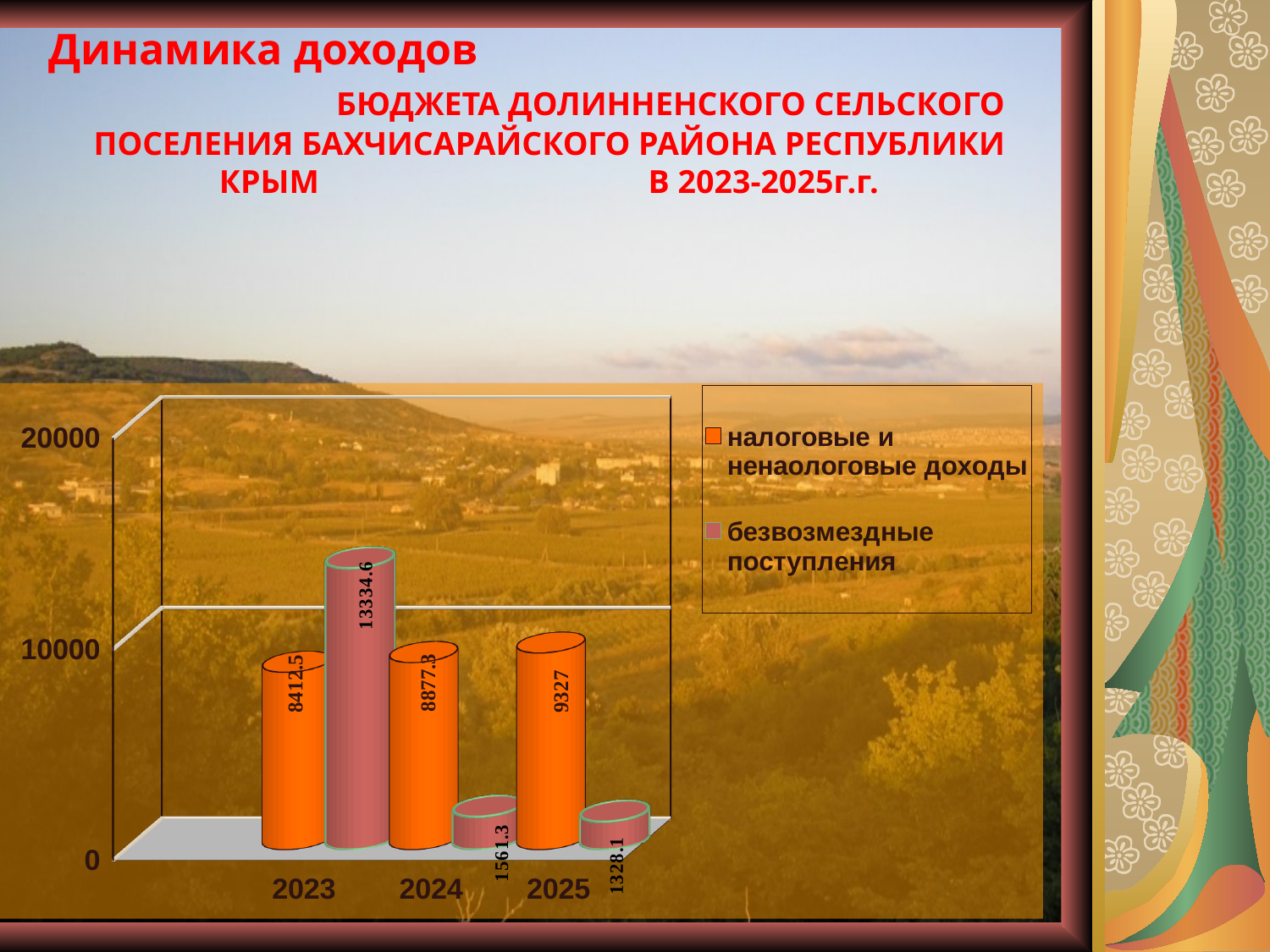
Do the values of налоговые и ненаологовые доходы rise or fall from 2023 to 2025? rise In which year is безвозмездные поступления highest? 2023 What is the value of налоговые и ненаологовые доходы for 2025? 9327 Is the value of безвозмездные поступления for 2023 greater or less than 10000? greater Which is larger in 2023: налоговые и ненаологовые доходы or безвозмездные поступления? безвозмездные поступления What is the value of безвозмездные поступления for 2023? 13334.6 How many series does the legend list? 2 In which year is безвозмездные поступления lowest? 2025 What is the value of безвозмездные поступления for 2024? 1561.3 What is the value of налоговые и ненаологовые доходы for 2023? 8412.5 How many years are shown on the x axis? 3 What is the difference between налоговые и ненаологовые доходы in 2025 and in 2023? 914.5